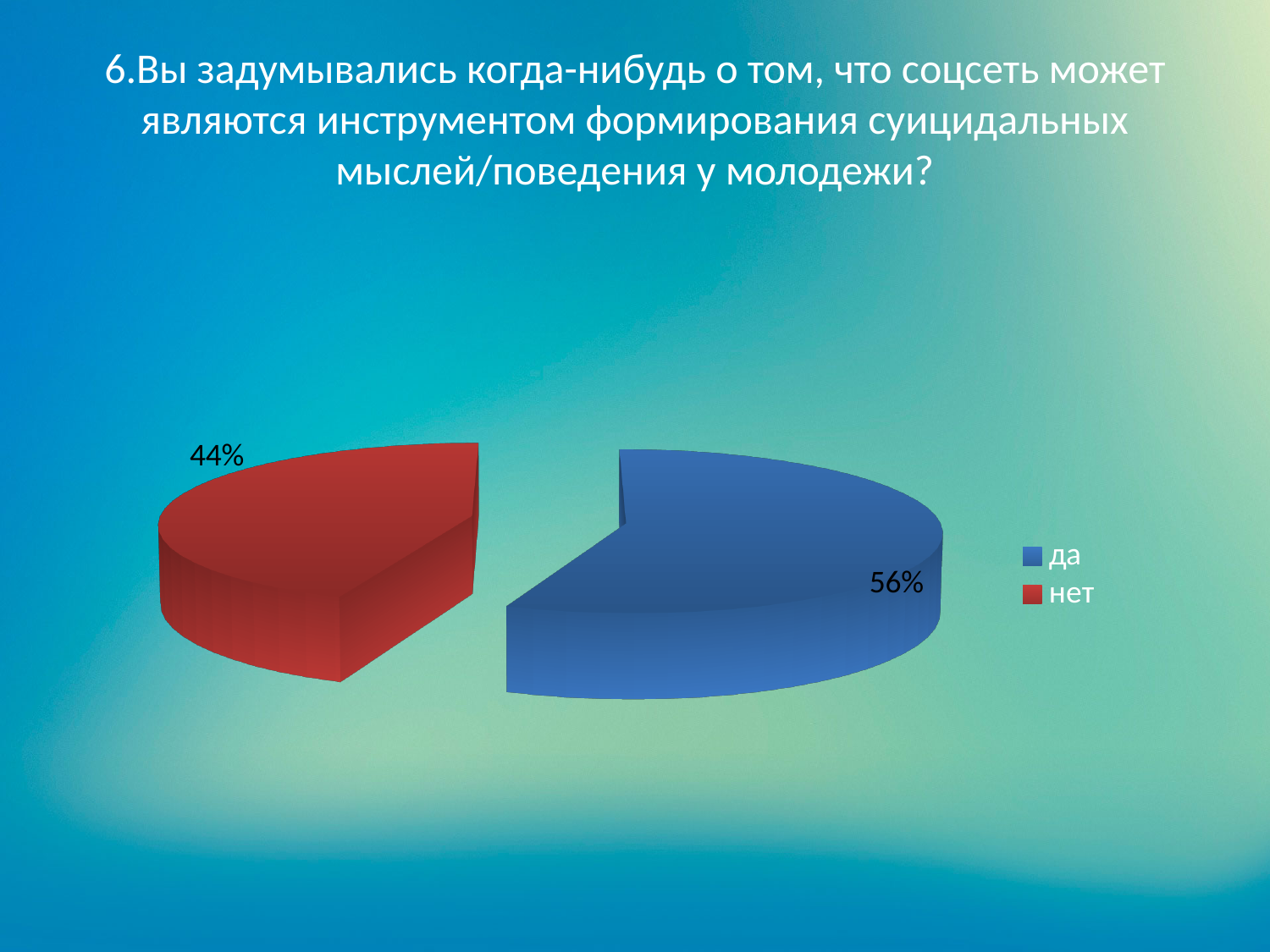
What share of the pie does "нет" have? 44% What share of the pie does "да" have? 56% How many slices does the pie chart have? 2 How many entries does the legend list? 2 Which is larger, the share for "да" or the share for "нет"? да Which slice is the largest? да What colour is the "нет" slice? red What is the difference in percentage points between "да" and "нет"? 12% What kind of chart is shown on the slide? pie chart What colour is the "да" slice? blue Which slice is the smallest? нет